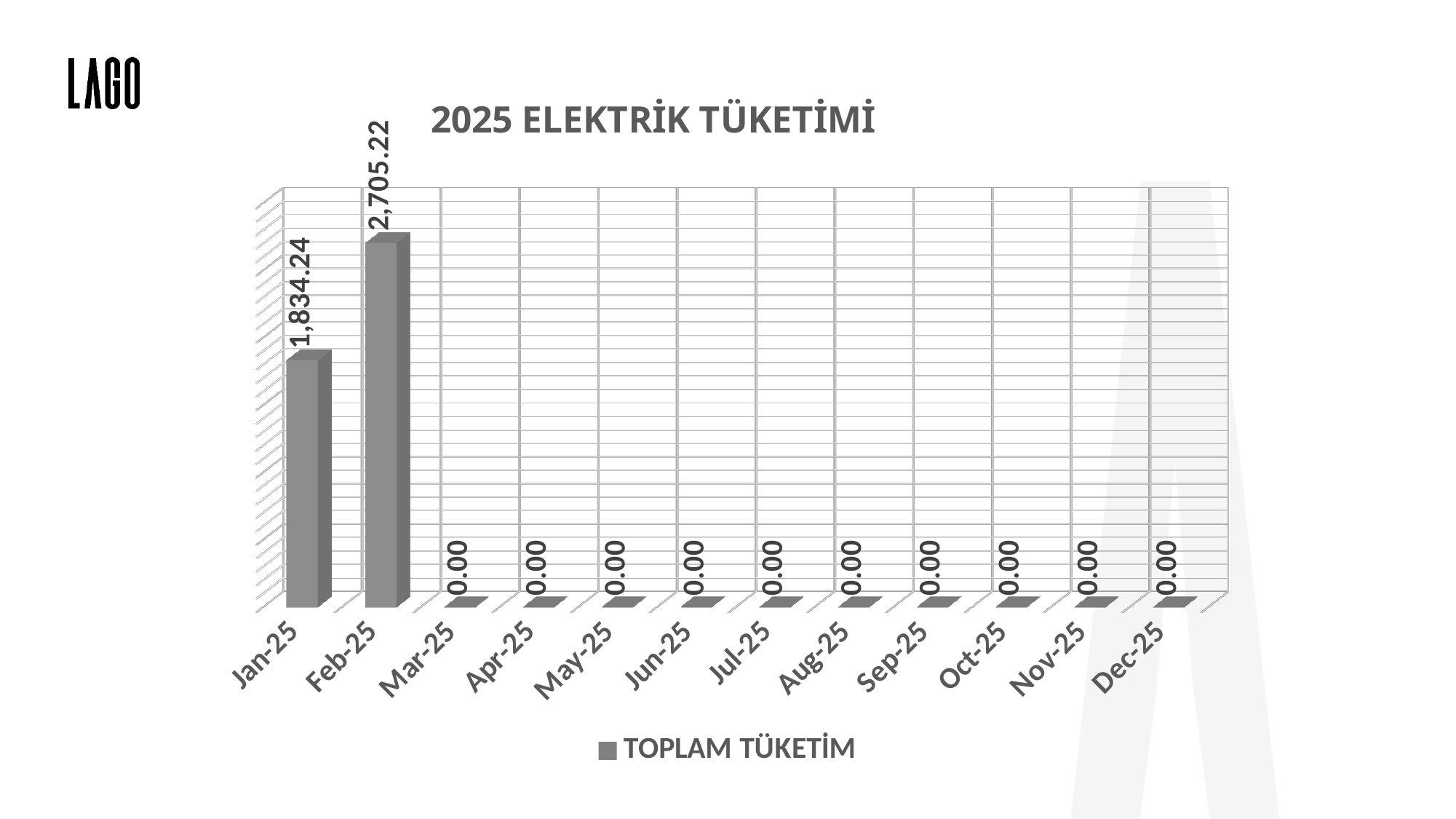
What is the title of the chart? 2025 ELEKTRİK TÜKETİMİ What kind of chart is shown? Bar chart Which month has the highest value? Feb-25 What is the difference between the values for Feb-25 and Jan-25? 870.98 What is the value for Feb-25? 2,705.22 Which is larger, the value for Jan-25 or the value for Feb-25? Feb-25 What is the value for Dec-25? 0.00 How many months are shown on the x axis? 12 How many series does the legend list? 1 What is the value for Jan-25? 1,834.24 What is the value for Mar-25? 0.00 How many months have a value of 0.00? 10